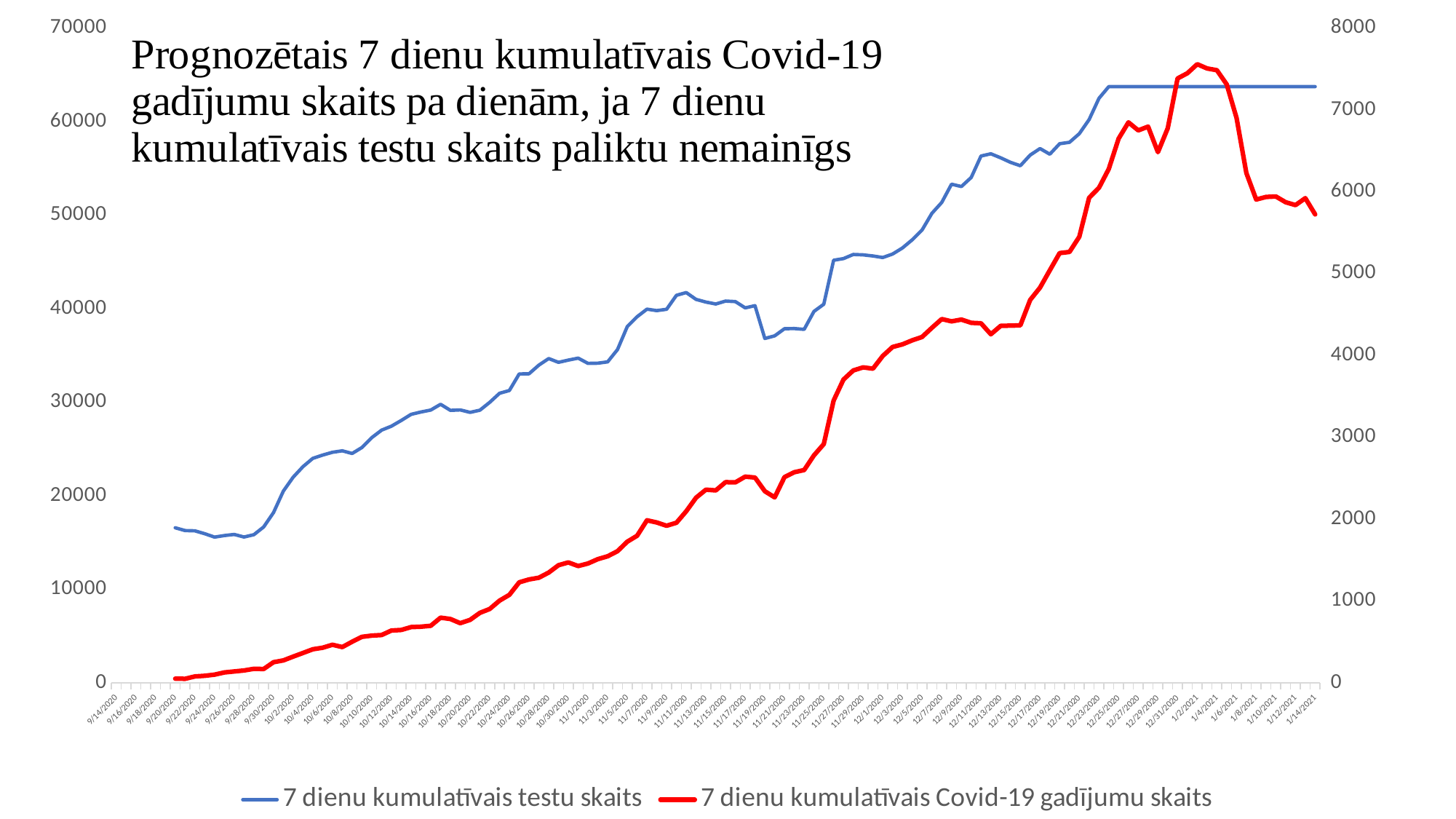
Is the highest value reached by '7 dienu kumulatīvais Covid-19 gadījumu skaits' greater or less than 7000 on the right axis? greater Is the value of '7 dienu kumulatīvais Covid-19 gadījumu skaits' at 9/20/2020 greater or less than 1000 on the right axis? less Is the value of '7 dienu kumulatīvais Covid-19 gadījumu skaits' at 1/14/2021 greater or less than 5000 on the right axis? greater Which series is drawn with the red line? 7 dienu kumulatīvais Covid-19 gadījumu skaits What kind of chart is shown on the slide? line chart How many series does the legend list? 2 What is the title of the chart? Prognozētais 7 dienu kumulatīvais Covid-19 gadījumu skaits pa dienām, ja 7 dienu kumulatīvais testu skaits paliktu nemainīgs Does the '7 dienu kumulatīvais Covid-19 gadījumu skaits' line rise or fall between 1/4/2021 and 1/14/2021? fall Does the '7 dienu kumulatīvais testu skaits' line generally rise or fall from 9/20/2020 to 12/25/2020? rise What is the highest tick value shown on the right-hand vertical axis? 8000